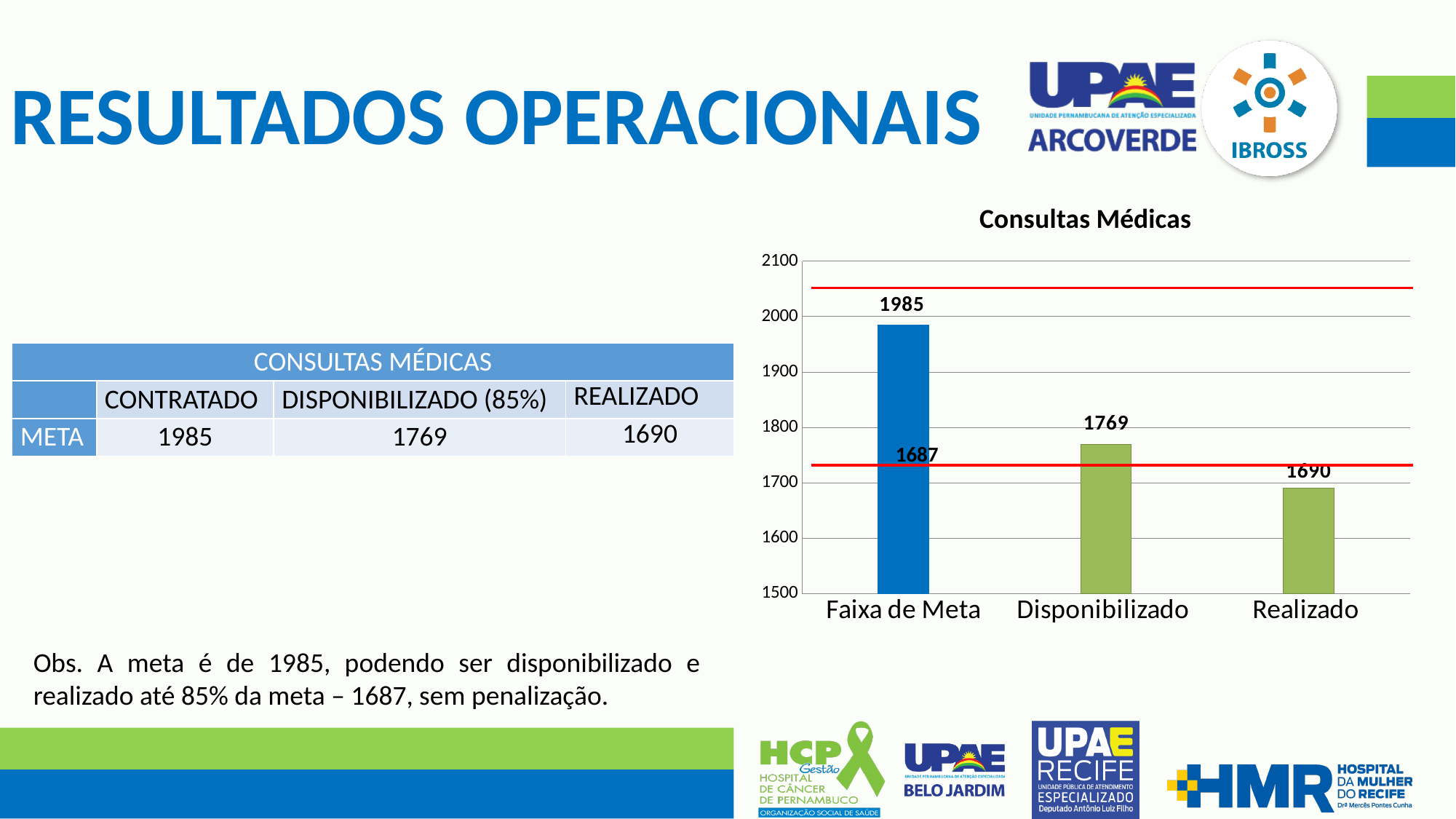
Do the bar values rise or fall from left to right across the x axis? fall What is the value labelled at the top of the Faixa de Meta bar? 1985 What type of chart is shown on the slide? bar chart Which category has the lowest bar in the chart? Realizado What is the value labelled on the Realizado bar? 1690 What is the difference between the Disponibilizado value (1769) and the Realizado value (1690)? 79 Is the value for Realizado greater or less than 1700? less Which is larger, the Disponibilizado bar or the Realizado bar? Disponibilizado Which category has the highest bar in the chart? Faixa de Meta What is the title of the chart? Consultas Médicas What is the value labelled on the Disponibilizado bar? 1769 How many categories are shown on the x axis of the chart? 3